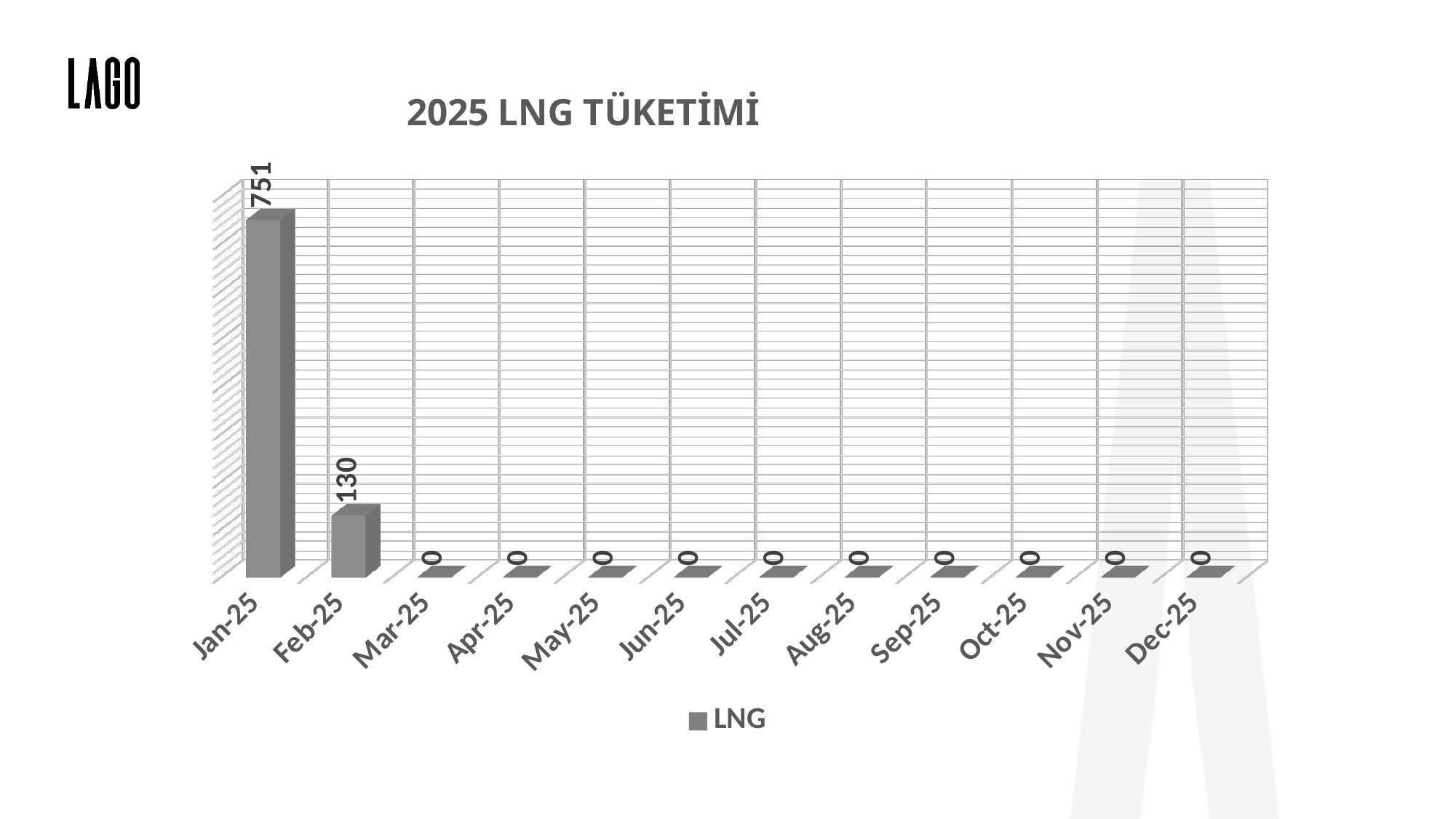
What is the title of the chart? 2025 LNG TÜKETİMİ What is the name of the series listed in the legend? LNG How many series does the legend list? 1 What is the LNG value for Mar-25? 0 Which month has the highest LNG value? Jan-25 What is the difference between the LNG values for Jan-25 and Feb-25? 621 What is the LNG value for Jan-25? 751 Which is larger, the LNG value for Jan-25 or for Feb-25? Jan-25 How many months are shown on the x axis? 12 Do the LNG values rise or fall from Jan-25 to Mar-25? fall What is the LNG value for Feb-25? 130 What kind of chart is shown on the slide? bar chart